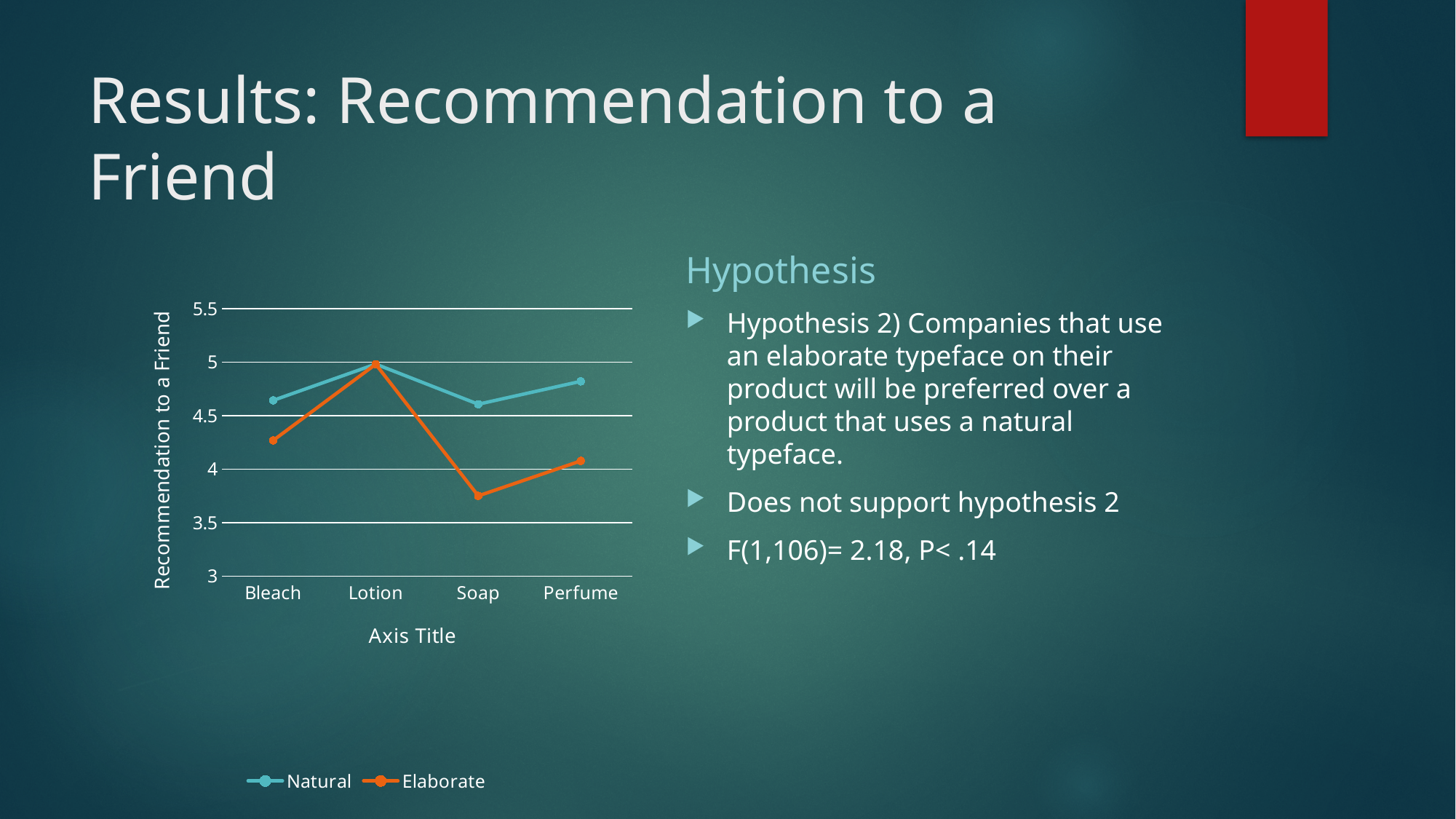
What is the title of the chart's vertical axis? Recommendation to a Friend Is the Elaborate value for Soap greater or less than 4? less What kind of chart is shown on the slide? line chart Is the Natural value for Perfume greater or less than 4.5? greater What are the two series named in the chart's legend? Natural and Elaborate For the Elaborate series, which product has the lowest value? Soap Does the Elaborate series rise or fall from Lotion to Soap? fall For the Natural series, which product has the highest value? Lotion How many series does the chart's legend list? 2 For the Elaborate series, which product has the highest value? Lotion How many product categories are shown on the x axis of the chart? 4 For Soap, which series has the larger value, Natural or Elaborate? Natural